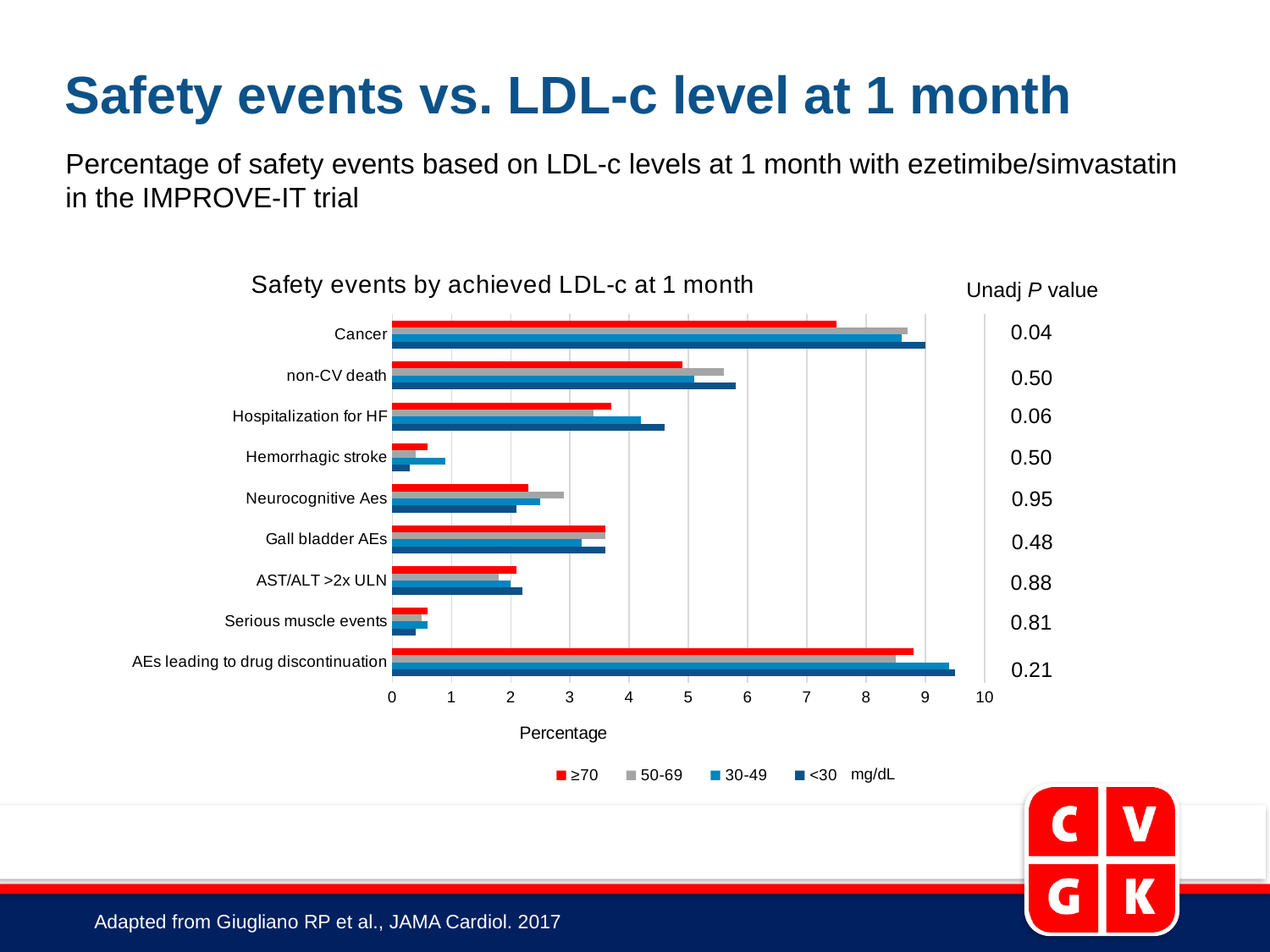
How many LDL-c level series does the legend list? 4 What is the unadjusted P value shown for Cancer? 0.04 Is the value for Cancer in the <30 mg/dL series greater or less than 8? greater Is the value for AEs leading to drug discontinuation in the <30 mg/dL series greater or less than 9? greater For Cancer, which is larger: the ≥70 mg/dL value or the <30 mg/dL value? <30 mg/dL Is the value for Cancer in the ≥70 mg/dL series greater or less than 7? greater How many safety event categories are plotted in the chart? 9 What kind of chart is shown on the slide? bar chart Which safety event has the highest value in the <30 mg/dL series? AEs leading to drug discontinuation What is the label on the x axis of the chart? Percentage